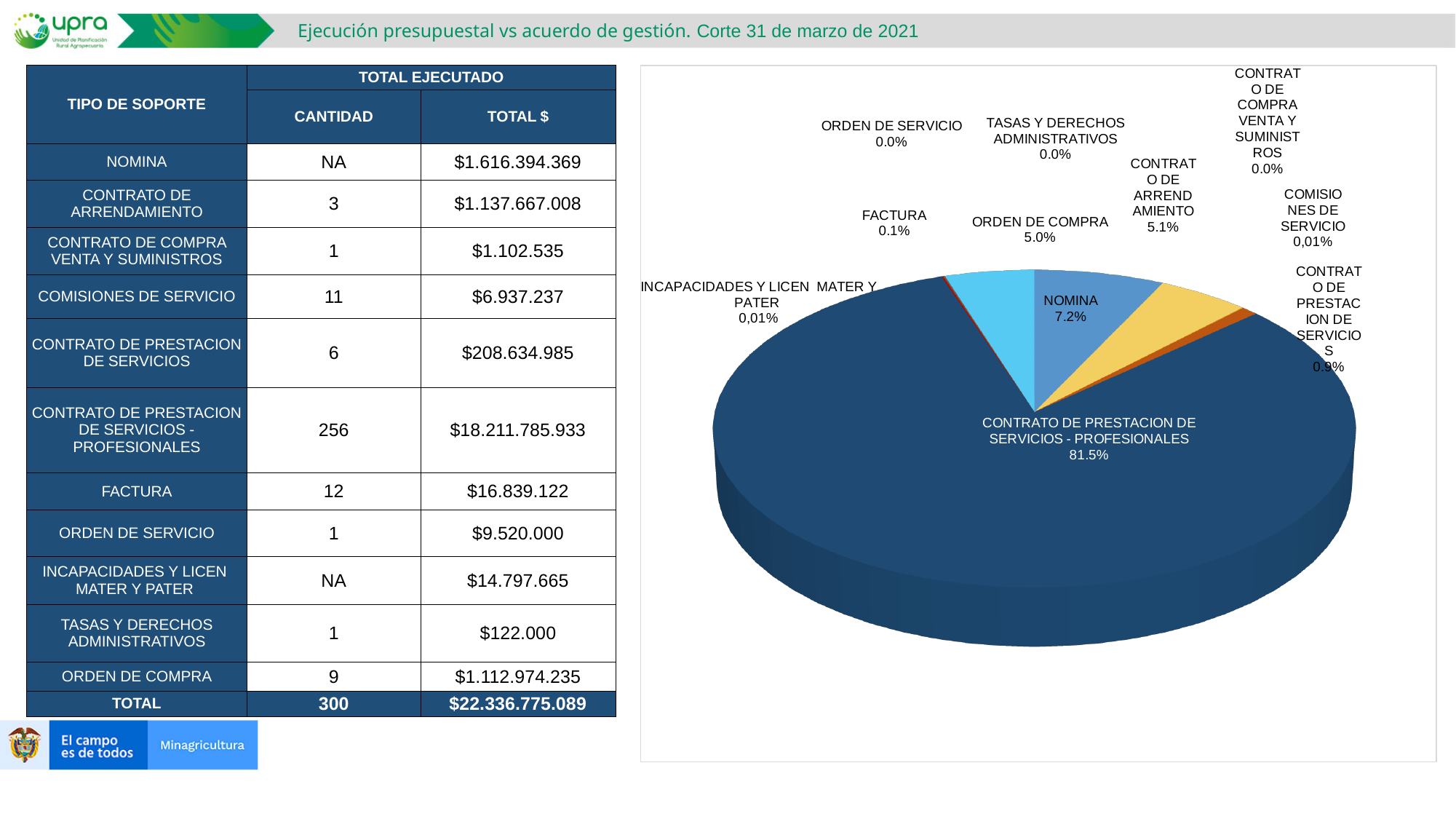
Which slice is larger in the pie chart, NOMINA or ORDEN DE COMPRA? NOMINA What percentage is shown for ORDEN DE COMPRA in the pie chart? 5.0% What percentage is shown for FACTURA in the pie chart? 0.1% What is the difference in percentage points between CONTRATO DE PRESTACION DE SERVICIOS - PROFESIONALES and NOMINA in the pie chart? 74.3% What percentage is shown for COMISIONES DE SERVICIO in the pie chart? 0,01% What percentage is shown for CONTRATO DE PRESTACION DE SERVICIOS in the pie chart? 0.9% What kind of chart is shown on the slide? pie chart What percentage is shown for CONTRATO DE ARRENDAMIENTO in the pie chart? 5.1% How many categories are labelled in the pie chart? 11 Which category has the largest slice of the pie chart? CONTRATO DE PRESTACION DE SERVICIOS - PROFESIONALES What percentage is shown for NOMINA in the pie chart? 7.2% What share of the pie does CONTRATO DE PRESTACION DE SERVICIOS - PROFESIONALES represent? 81.5%